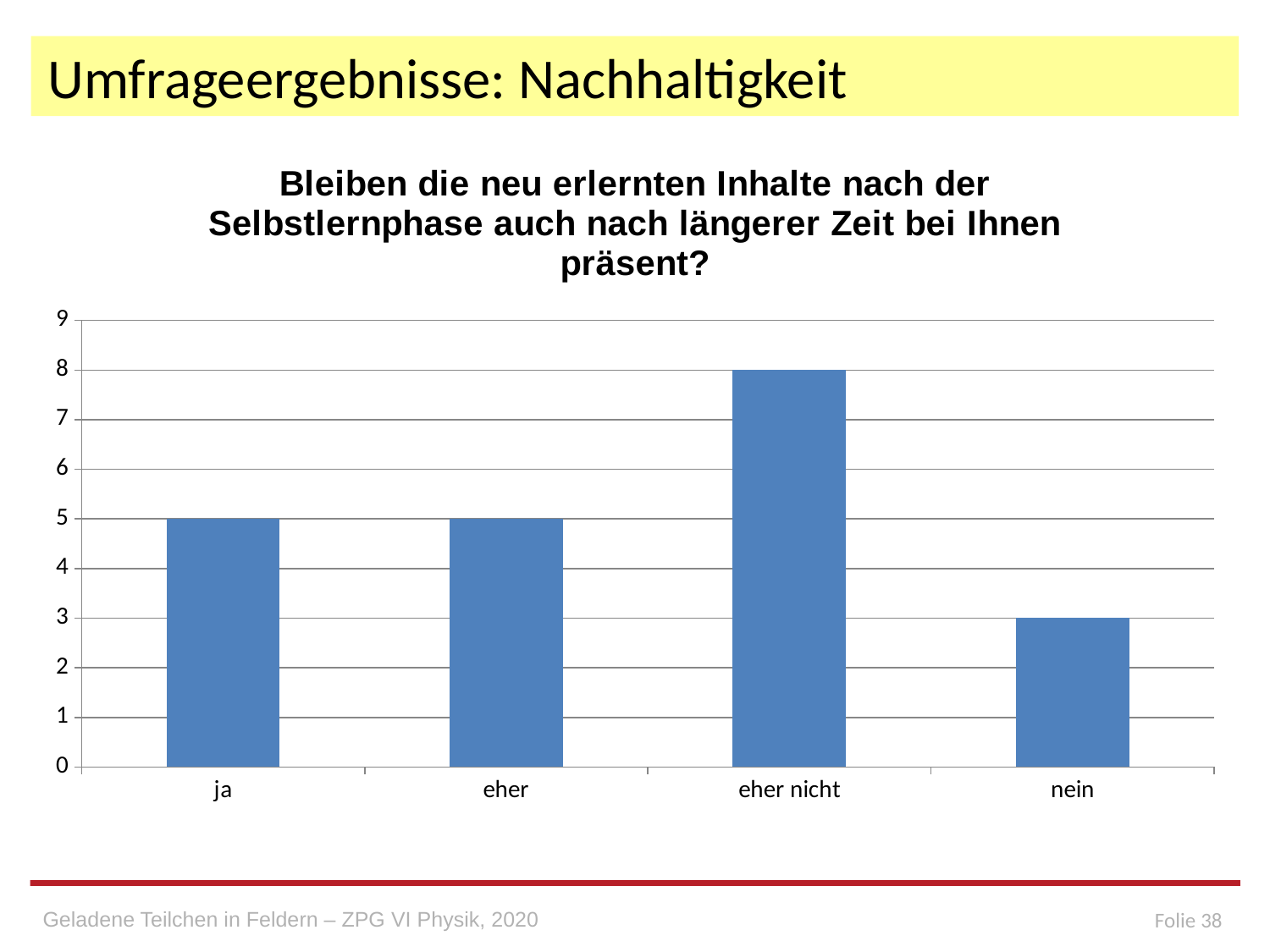
Which category has the highest value? eher nicht Is the value for "eher nicht" greater or less than 6? greater What kind of chart is shown on the slide? bar chart What is the value for "nein"? 3 Which category has the lowest value? nein Which is larger, the value for "eher" or the value for "nein"? eher What is the title of the chart? Bleiben die neu erlernten Inhalte nach der Selbstlernphase auch nach längerer Zeit bei Ihnen präsent? What is the total of the values for "ja" and "eher"? 10 What is the difference between the values for "eher nicht" and "nein"? 5 What is the value for "ja"? 5 How many categories are shown on the x axis of the chart? 4 What is the value for "eher nicht"? 8